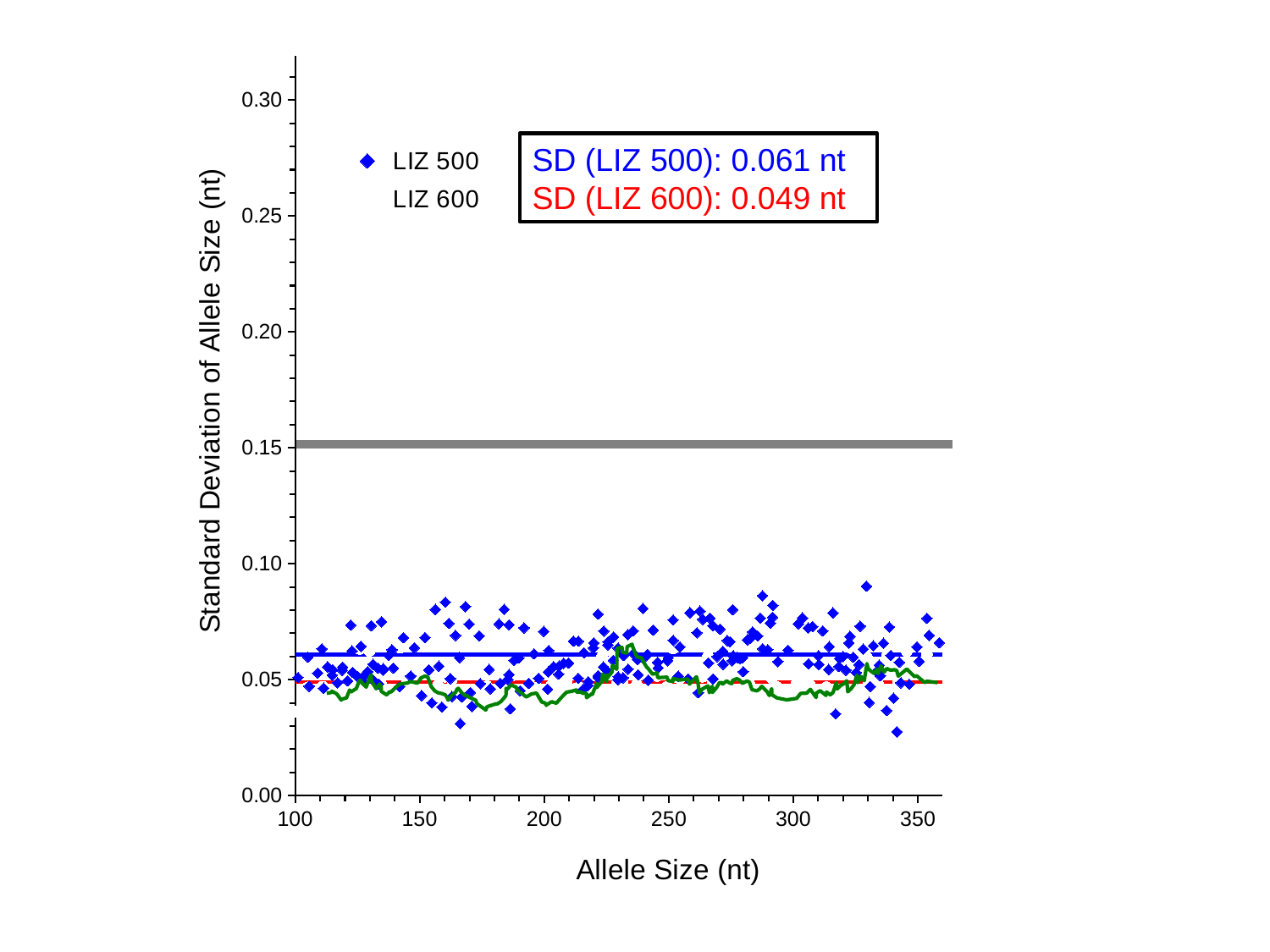
What is the label of the y axis? Standard Deviation of Allele Size (nt) What is the label of the x axis? Allele Size (nt) What is the SD value given for LIZ 600? 0.049 nt What is the difference between the SD of LIZ 500 and the SD of LIZ 600? 0.012 nt Do the LIZ 500 values show a clear rising or falling trend as allele size increases? Neither; roughly flat Which has the larger SD, LIZ 500 or LIZ 600? LIZ 500 What kind of chart is shown on the slide? Scatter plot How many series does the legend list? 2 What is the SD value given for LIZ 500? 0.061 nt Is the highest LIZ 600 value greater or less than 0.10? less Is the highest LIZ 500 data point greater or less than 0.10? less